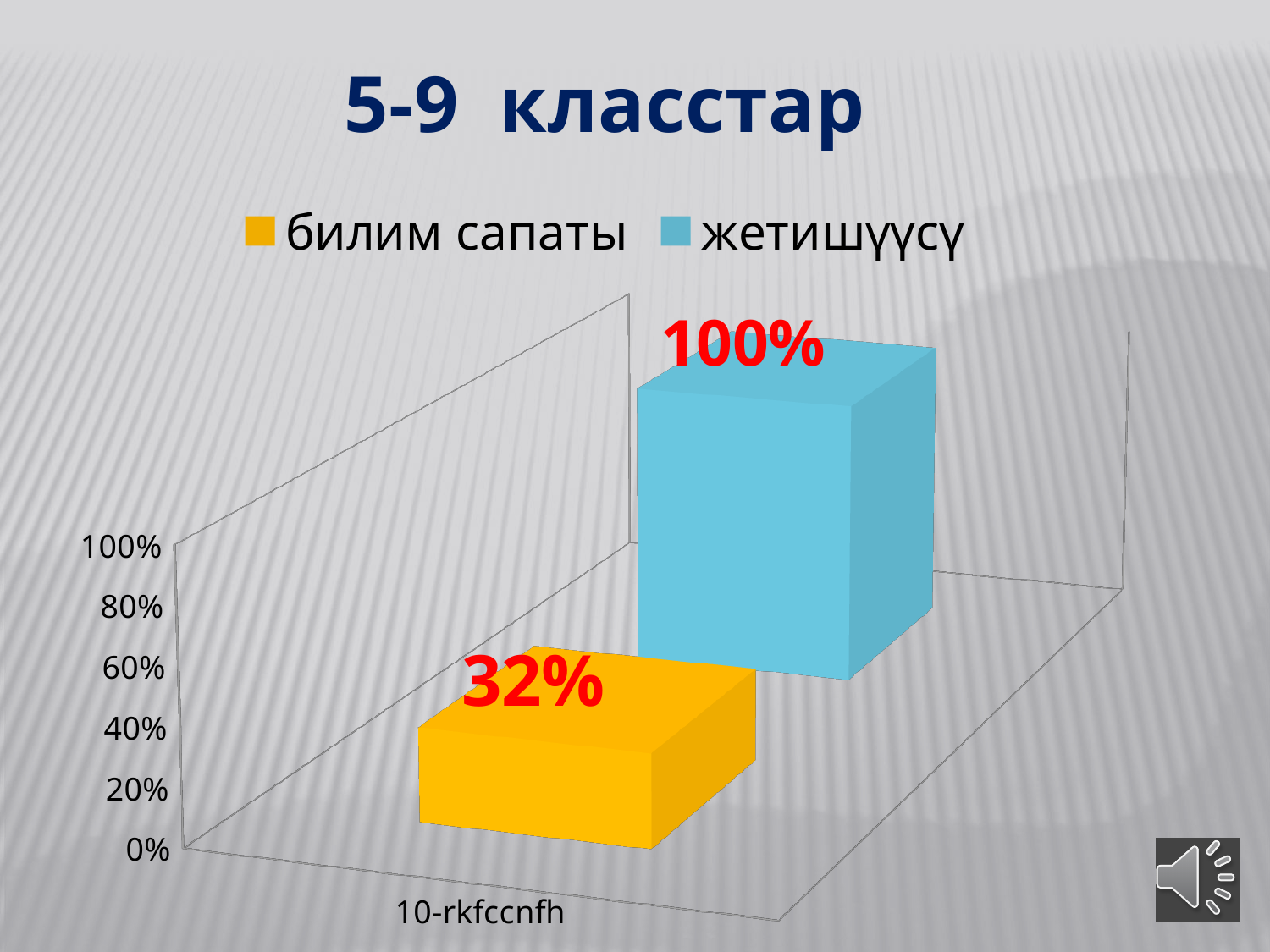
Which series has the lowest value? билим сапаты What kind of chart is shown on the slide? bar chart Which series has the highest value? жетишүүсү Is the value for билим сапаты greater or less than 40%? less What is the difference between the жетишүүсү value and the билим сапаты value? 68% What is the title of the slide? 5-9 класстар How many categories are shown on the x axis? 1 What is the value for жетишүүсү? 100% What is the value for билим сапаты? 32% Which series has the higher value, билим сапаты or жетишүүсү? жетишүүсү Is the value for жетишүүсү greater or less than 80%? greater How many series does the legend list? 2